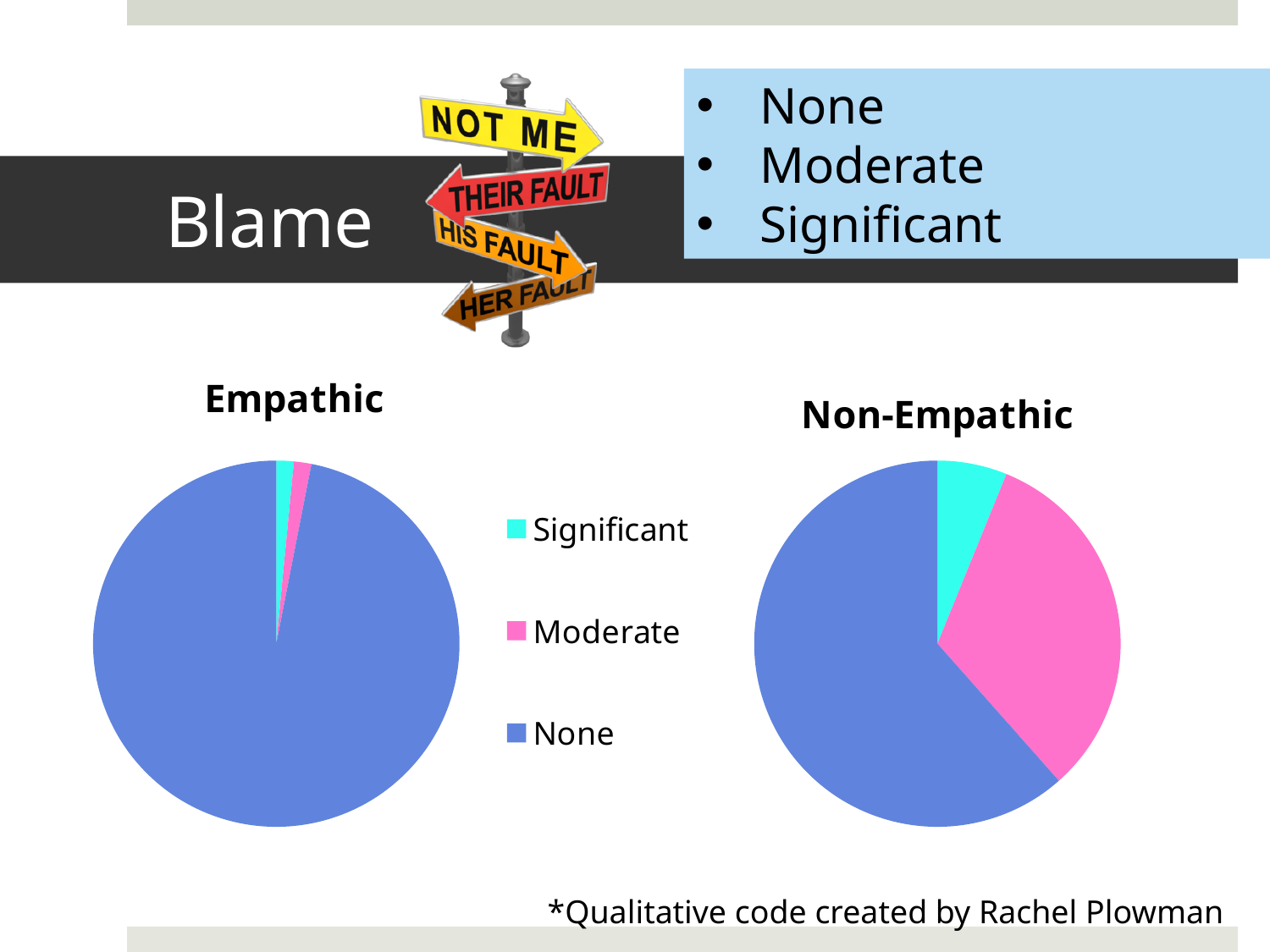
In the Empathic pie chart, which category has the largest slice? None What kind of chart is the Empathic chart? pie chart In the Non-Empathic pie chart, which slice is larger, None or Moderate? None Which colour represents the None category in the pie charts? blue In the Non-Empathic pie chart, which category has the largest slice? None In the Non-Empathic pie chart, which category has the smallest slice? Significant Which chart has the larger Moderate slice, Empathic or Non-Empathic? Non-Empathic How many categories does the legend list for the pie charts? 3 What is the title of the pie chart on the right side of the slide? Non-Empathic How many slices does the Non-Empathic pie chart have? 3 In the Non-Empathic pie chart, which slice is larger, Moderate or Significant? Moderate What kind of chart is the Non-Empathic chart? pie chart